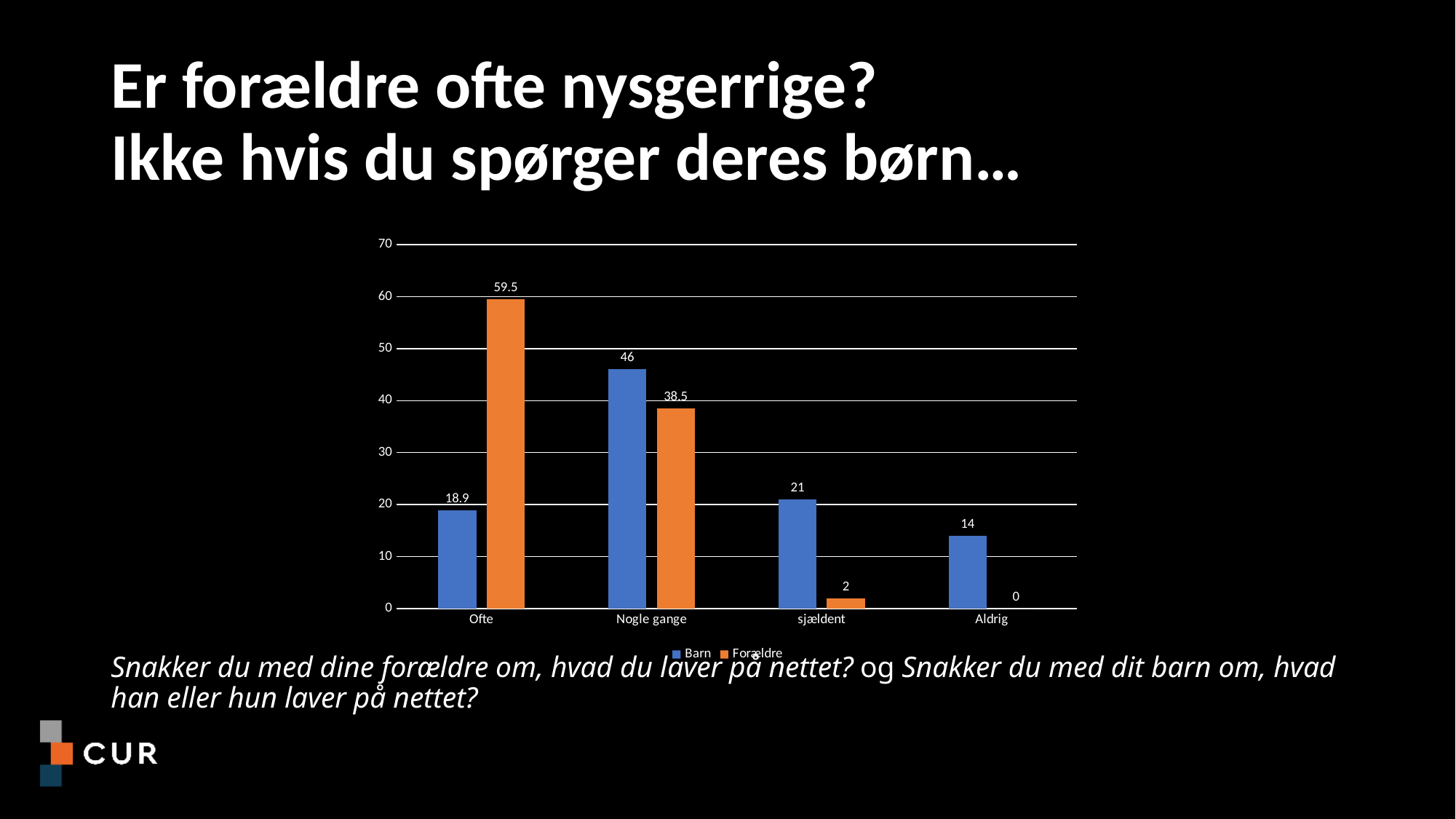
What kind of chart is shown on the slide? Bar chart In the Nogle gange category, which series has the larger value, Barn or Forældre? Barn What is the value for Forældre in the Aldrig category? 0 How many series does the legend list? 2 What is the value for Forældre in the Ofte category? 59.5 How many categories are shown on the x axis? 4 Which category has the highest value for Barn? Nogle gange What is the value for Barn in the Nogle gange category? 46 What is the value for Forældre in the sjældent category? 2 Which category has the lowest value for Forældre? Aldrig What is the difference between the Forældre and Barn values in the Ofte category? 40.6 What is the value for Barn in the Ofte category? 18.9